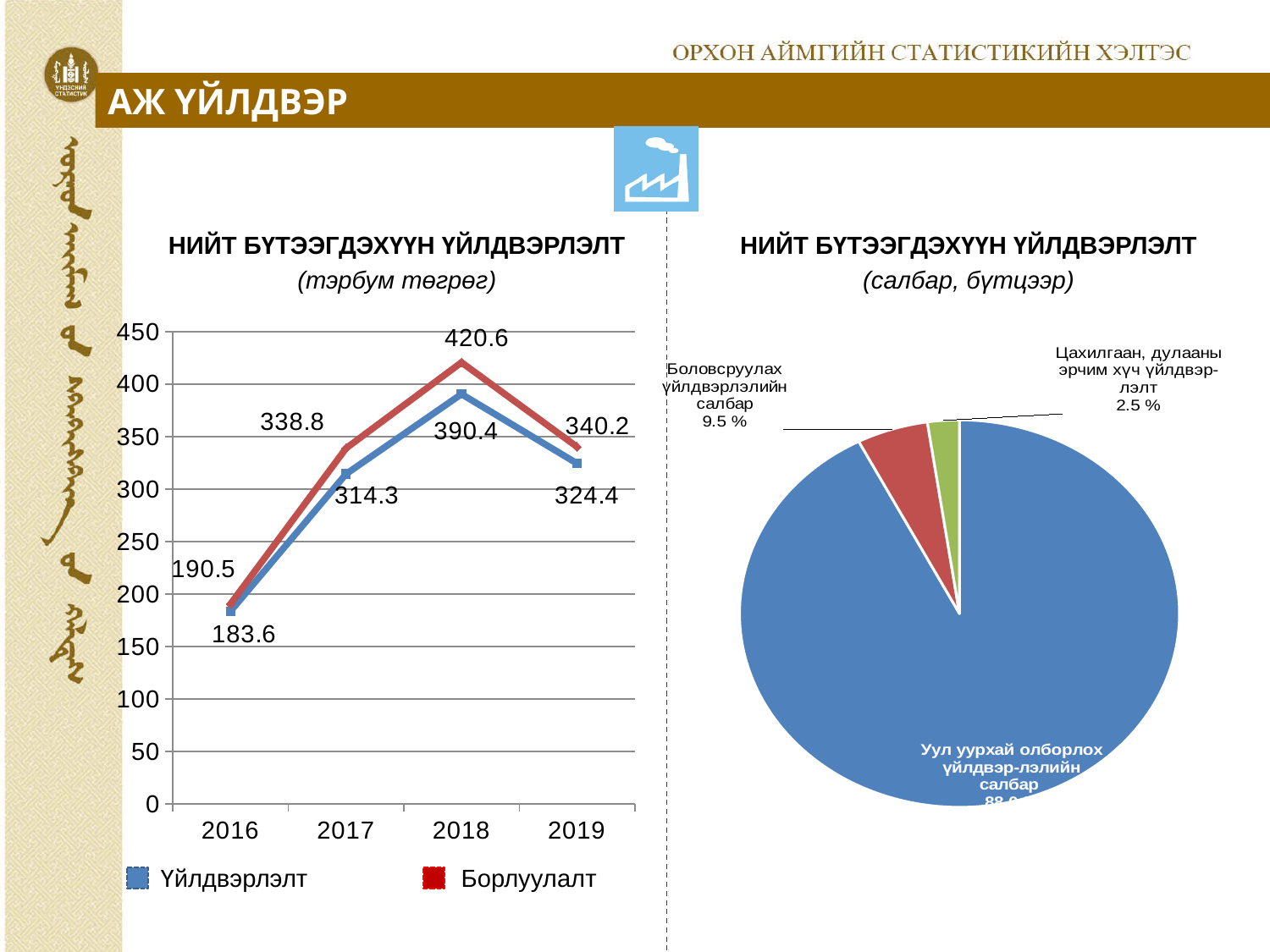
In the pie chart on the right, what share does Боловсруулах үйлдвэрлэлийн салбар have? 9.5 % In the line chart on the left, what is the value of Борлуулалт in 2019? 340.2 In the line chart on the left, what is the difference between Борлуулалт and Үйлдвэрлэлт in 2017? 24.5 In the line chart on the left, what is the value of Үйлдвэрлэлт in 2018? 390.4 In the line chart on the left, how many series does the legend list? 2 In the line chart on the left, what is the value of Борлуулалт in 2016? 190.5 In the line chart on the left, which is larger in 2019: Үйлдвэрлэлт or Борлуулалт? Борлуулалт In the line chart on the left, in which year is Борлуулалт highest? 2018 In the line chart on the left, does Үйлдвэрлэлт rise or fall from 2018 to 2019? fall In the line chart on the left, how many years are shown on the x axis? 4 In the line chart on the left, in which year is Үйлдвэрлэлт lowest? 2016 In the pie chart on the right, which sector has the largest slice? Уул уурхай олборлох үйлдвэрлэлийн салбар